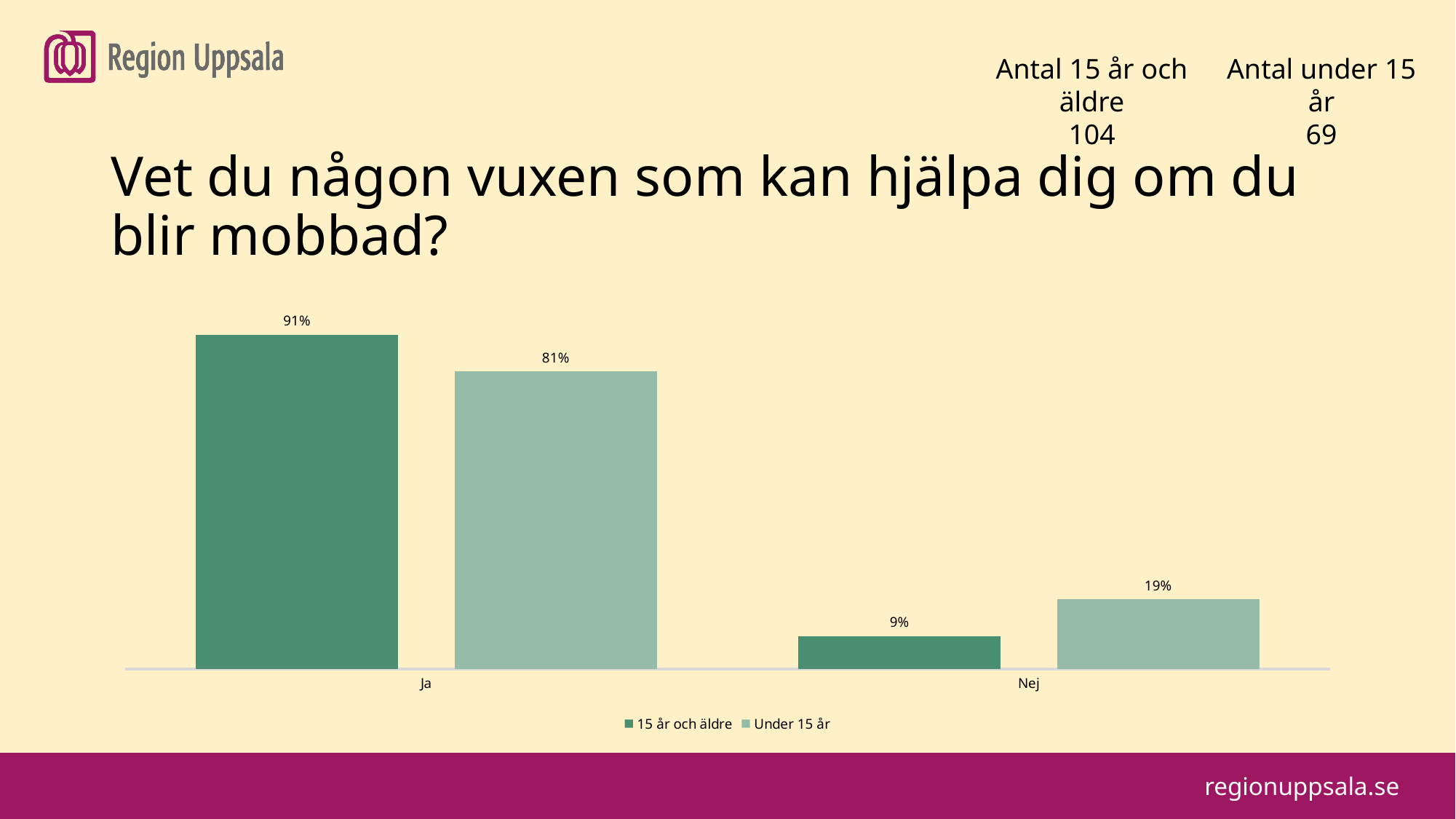
How many series does the legend list? 2 What kind of chart is shown on the slide? Bar chart For the Nej category, which group has the larger value: 15 år och äldre or Under 15 år? Under 15 år What percentage of respondents Under 15 år answered Nej? 19% How many respondents aged 15 år och äldre are reported on the slide? 104 What percentage of respondents aged 15 år och äldre answered Nej? 9% Which bar in the chart has the lowest value? Nej, 15 år och äldre What percentage of respondents Under 15 år answered Ja? 81% What is the difference between the Ja values for 15 år och äldre and Under 15 år? 10 percentage points What percentage of respondents aged 15 år och äldre answered Ja? 91% Which bar in the chart has the highest value? Ja, 15 år och äldre How many categories are shown on the x axis? 2